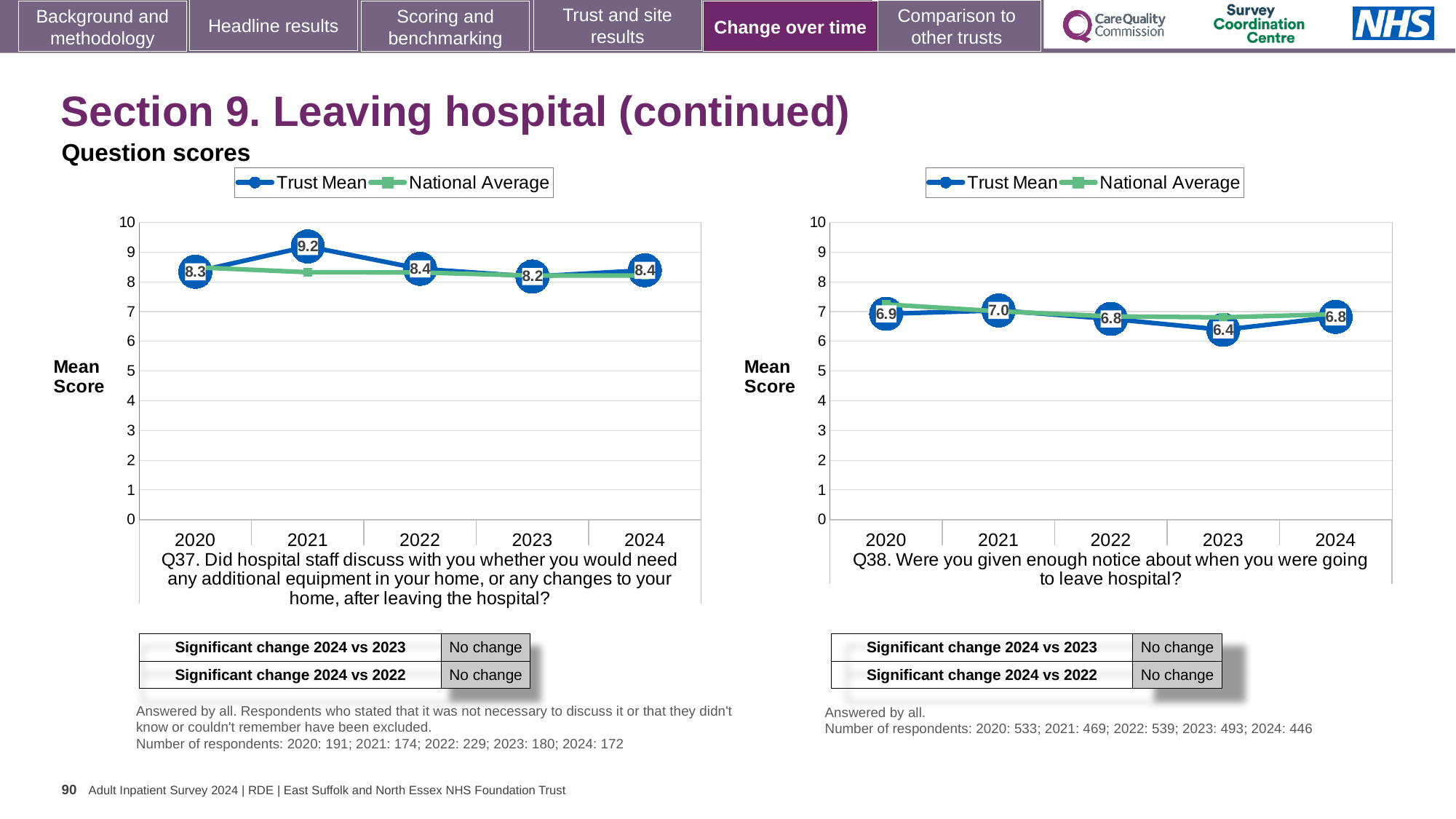
In the Q37 chart (left), what is the difference between the Trust Mean scores for 2021 and 2023? 1.0 In the Q37 chart (left), what is the Trust Mean score for 2021? 9.2 In the Q38 chart (right), which is larger: the Trust Mean score for 2021 or for 2023? 2021 In the Q38 chart (right), is the National Average for 2020 greater or less than 6? greater In the Q38 chart (right), which year has the lowest Trust Mean score? 2023 In the Q38 chart (right), what is the Trust Mean score for 2023? 6.4 In the Q37 chart (left), what is the Trust Mean score for 2023? 8.2 How many years are plotted on the x axis of the Q37 chart (left)? 5 In the Q37 chart (left), which year has the highest Trust Mean score? 2021 What type of chart is the Q37 chart (left)? Line chart How many series does the legend of the Q38 chart (right) list? 2 In the Q38 chart (right), what is the Trust Mean score for 2024? 6.8